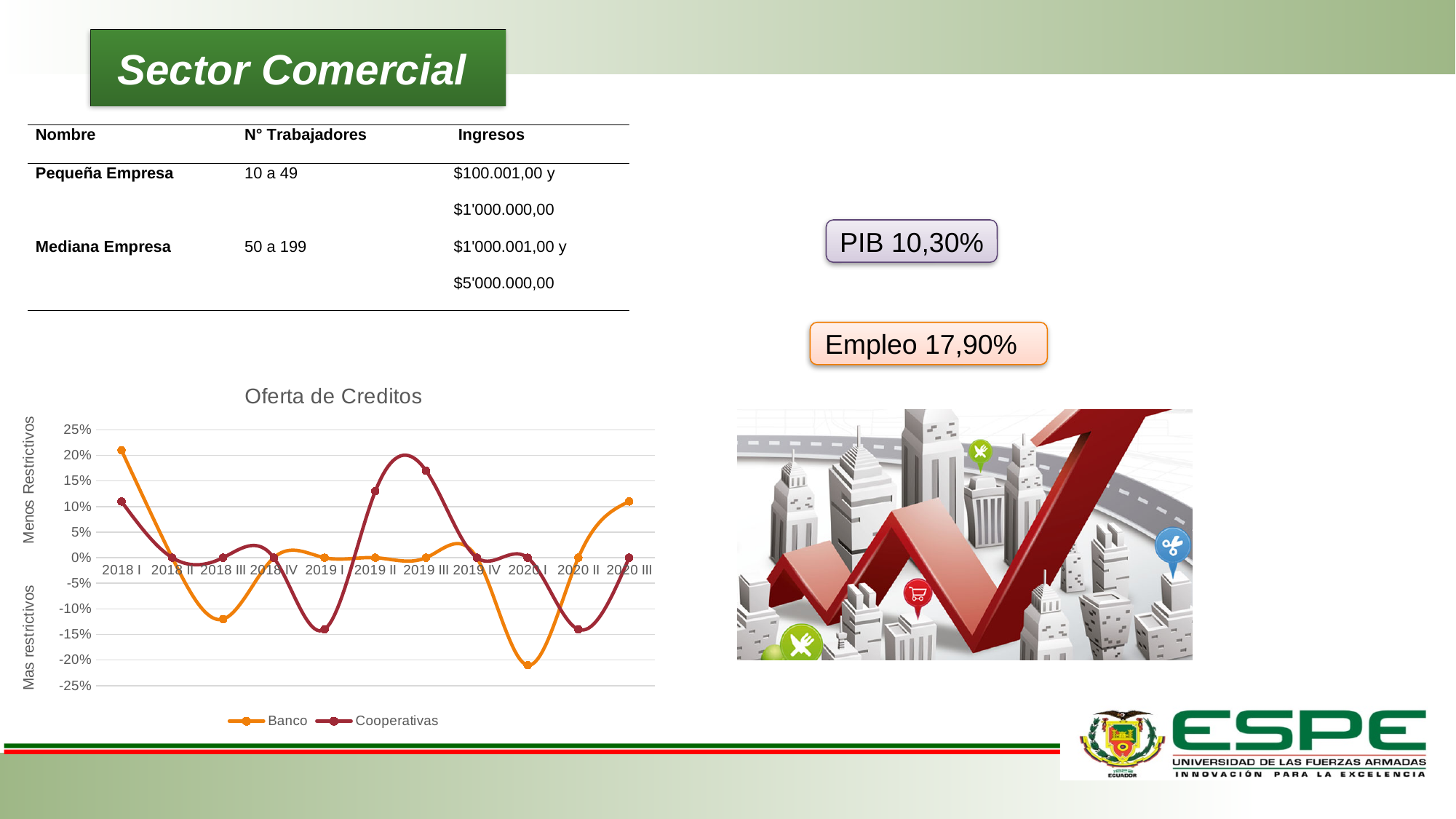
In the "Oferta de Creditos" chart, is the value for Cooperativas in 2019 III greater or less than 15%? greater Which series in the "Oferta de Creditos" chart is drawn in orange? Banco What kind of chart is "Oferta de Creditos"? line chart How many series does the legend of the "Oferta de Creditos" chart list? 2 In the "Oferta de Creditos" chart, which series has the higher value in 2019 II, Banco or Cooperativas? Cooperativas In the "Oferta de Creditos" chart, what is the value for Cooperativas in 2018 III? 0% In the "Oferta de Creditos" chart, is the value for Banco in 2018 I greater or less than 15%? greater In the "Oferta de Creditos" chart, is the value for Banco in 2020 I greater or less than -15%? less How many periods are shown on the x axis of the "Oferta de Creditos" chart? 11 In the "Oferta de Creditos" chart, what is the value for Banco in 2019 I? 0% In the "Oferta de Creditos" chart, which period has the lowest value for Banco? 2020 I